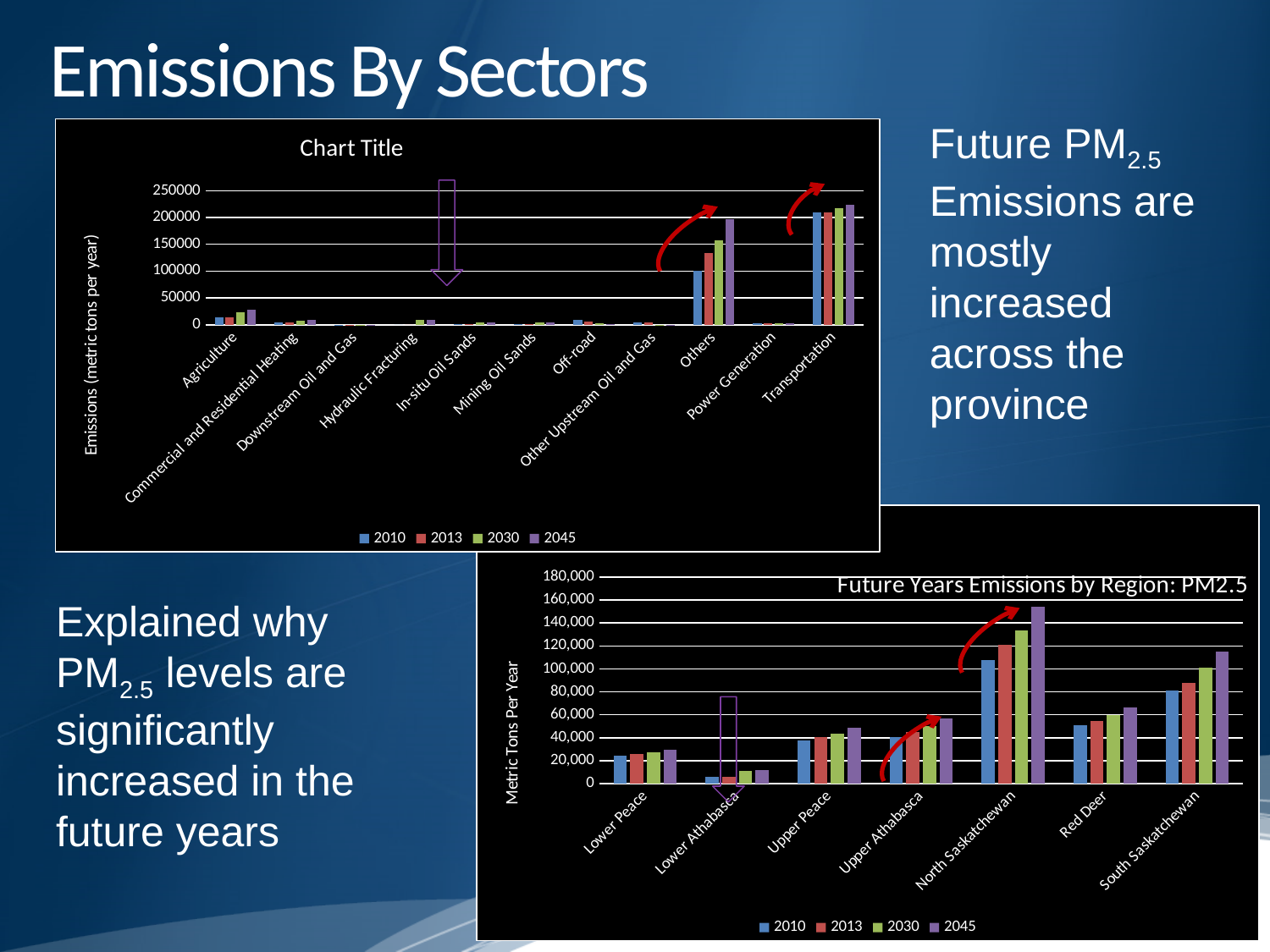
In the bottom chart ("Future Years Emissions by Region: PM2.5"), which region has the highest emissions? North Saskatchewan In the top chart ("Chart Title"), do the values for Others rise or fall from 2010 to 2045? rise In the top chart ("Chart Title"), is the 2045 value for Transportation greater or less than 200000? greater In the bottom chart ("Future Years Emissions by Region: PM2.5"), is the 2045 value for North Saskatchewan greater or less than 140,000? greater In the top chart ("Chart Title"), is the 2013 value for Others greater or less than 100000? greater In the bottom chart ("Future Years Emissions by Region: PM2.5"), which is larger for 2045: North Saskatchewan or South Saskatchewan? North Saskatchewan In the bottom chart ("Future Years Emissions by Region: PM2.5"), how many regions are shown on the x axis? 7 In the bottom chart ("Future Years Emissions by Region: PM2.5"), which region has the lowest emissions? Lower Athabasca In the top chart ("Chart Title"), how many series does the legend list? 4 In the top chart ("Chart Title"), which sector has the highest emissions? Transportation In the top chart ("Chart Title"), how many sector categories are shown on the x axis? 11 What type of chart is the top chart titled "Chart Title"? bar chart